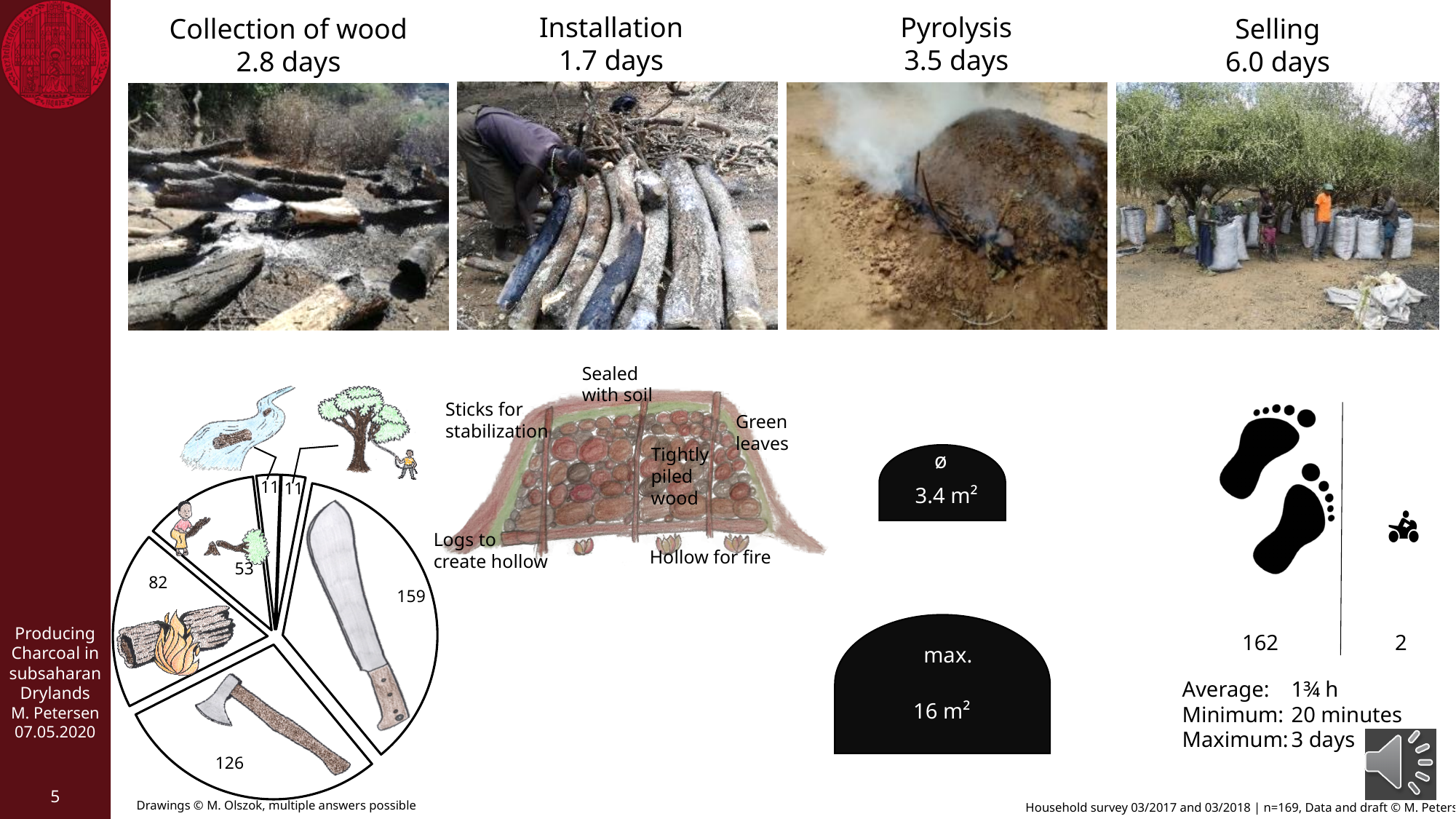
In the pie chart on the left, what value is shown on the slice with the burning logs drawing? 82 In the pie chart on the left, what value is shown on the slice with the axe drawing? 126 How many slices in the pie chart on the left are labelled with the value 11? 2 In the pie chart on the left, what is the smallest value shown? 11 What kind of chart is shown at the bottom left of the slide, under 'Collection of wood'? pie chart In the pie chart on the left, which slice has the larger value: the burning logs slice or the child and tree slice? burning logs slice (82) In the pie chart on the left, what value is shown on the slice with the child and small tree drawing? 53 In the pie chart on the left, what value is shown on the slice with the machete drawing? 159 In the pie chart on the left, what is the sum of all the slice values shown? 442 In the pie chart on the left, what is the largest value shown? 159 How many slices does the pie chart on the left have? 6 In the pie chart on the left, what is the difference between the machete slice (159) and the axe slice (126)? 33